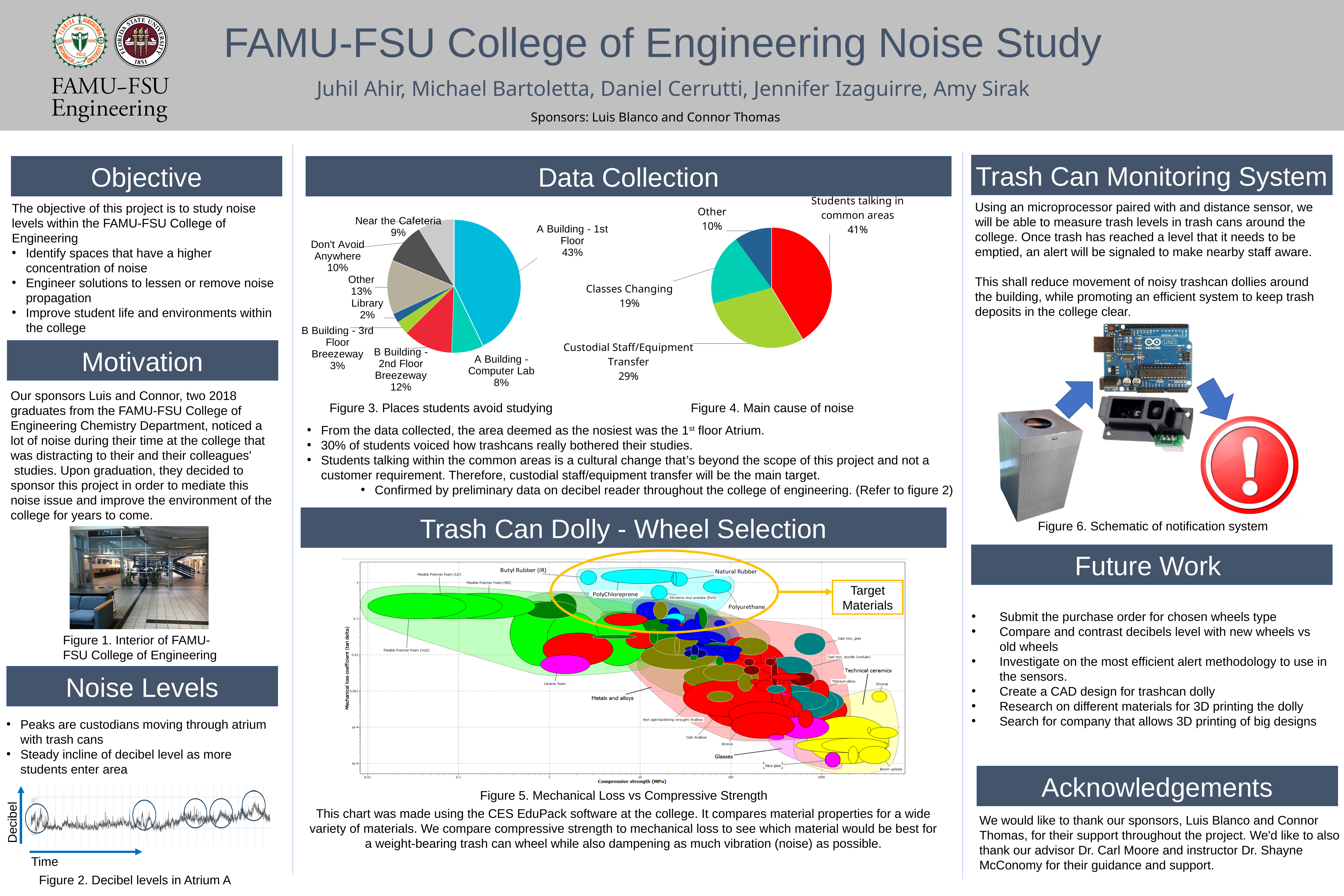
In Figure 3 (Places students avoid studying), what share of students avoid the A Building - 1st Floor? 43% In Figure 4 (Main cause of noise), what percentage is attributed to Custodial Staff/Equipment Transfer? 29% In Figure 3 (Places students avoid studying), which category has the smallest share? Library In Figure 3 (Places students avoid studying), what percentage is shown for the Library? 2% In Figure 4 (Main cause of noise), what percentage is attributed to Students talking in common areas? 41% In Figure 4 (Main cause of noise), which cause has the smallest share? Other In Figure 3 (Places students avoid studying), which is larger: Other or Don't Avoid Anywhere? Other In Figure 3 (Places students avoid studying), which place has the largest share? A Building - 1st Floor In Figure 4 (Main cause of noise), how many causes are shown in the pie chart? 4 In Figure 3 (Places students avoid studying), what is the difference in percentage points between the B Building - 2nd Floor Breezeway and the B Building - 3rd Floor Breezeway? 9 What type of chart is Figure 4 (Main cause of noise)? Pie chart In Figure 3 (Places students avoid studying), how many slices does the pie chart have? 8